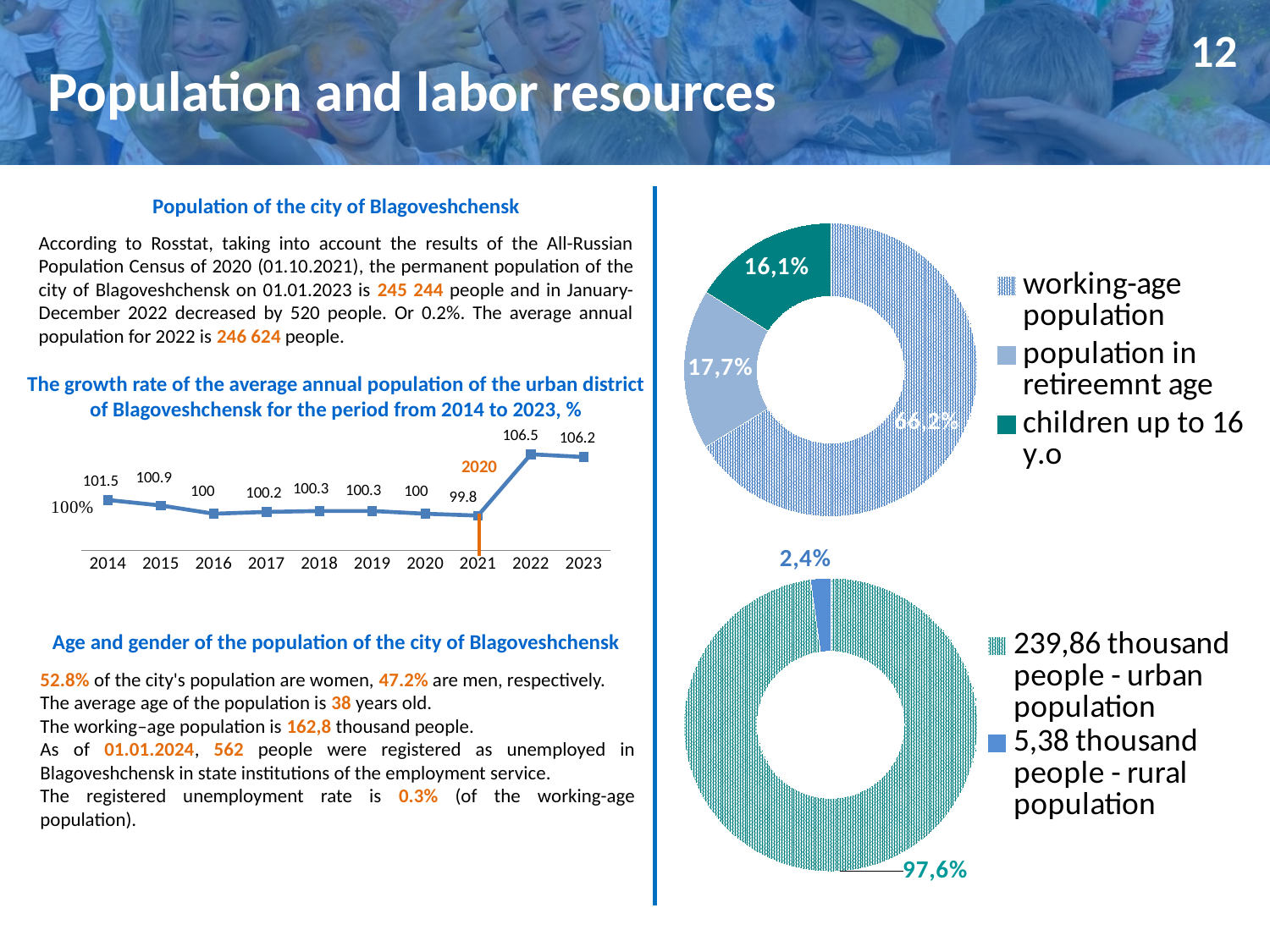
In the upper doughnut chart on the right, how many entries does the legend list? 3 In the line chart of the growth rate of the average annual population, is the value for 2014 larger or smaller than the value for 2015? Larger In the line chart of the growth rate of the average annual population, what is the difference between the values for 2022 and 2021? 6.7 In the line chart of the growth rate of the average annual population, what is the value for 2021? 99.8 In the upper doughnut chart on the right, what share is the working-age population? 66,2% In the lower doughnut chart on the right, what share is the rural population? 2,4% What type of chart shows the growth rate of the average annual population from 2014 to 2023? Line chart In the line chart of the growth rate of the average annual population, which year has the lowest value? 2021 In the upper doughnut chart on the right, what share is children up to 16 y.o? 16,1% In the line chart 'The growth rate of the average annual population of the urban district of Blagoveshchensk for the period from 2014 to 2023, %', what is the value for 2022? 106.5 In the line chart of the growth rate of the average annual population, how many years are plotted? 10 In the line chart of the growth rate of the average annual population, which year has the highest value? 2022